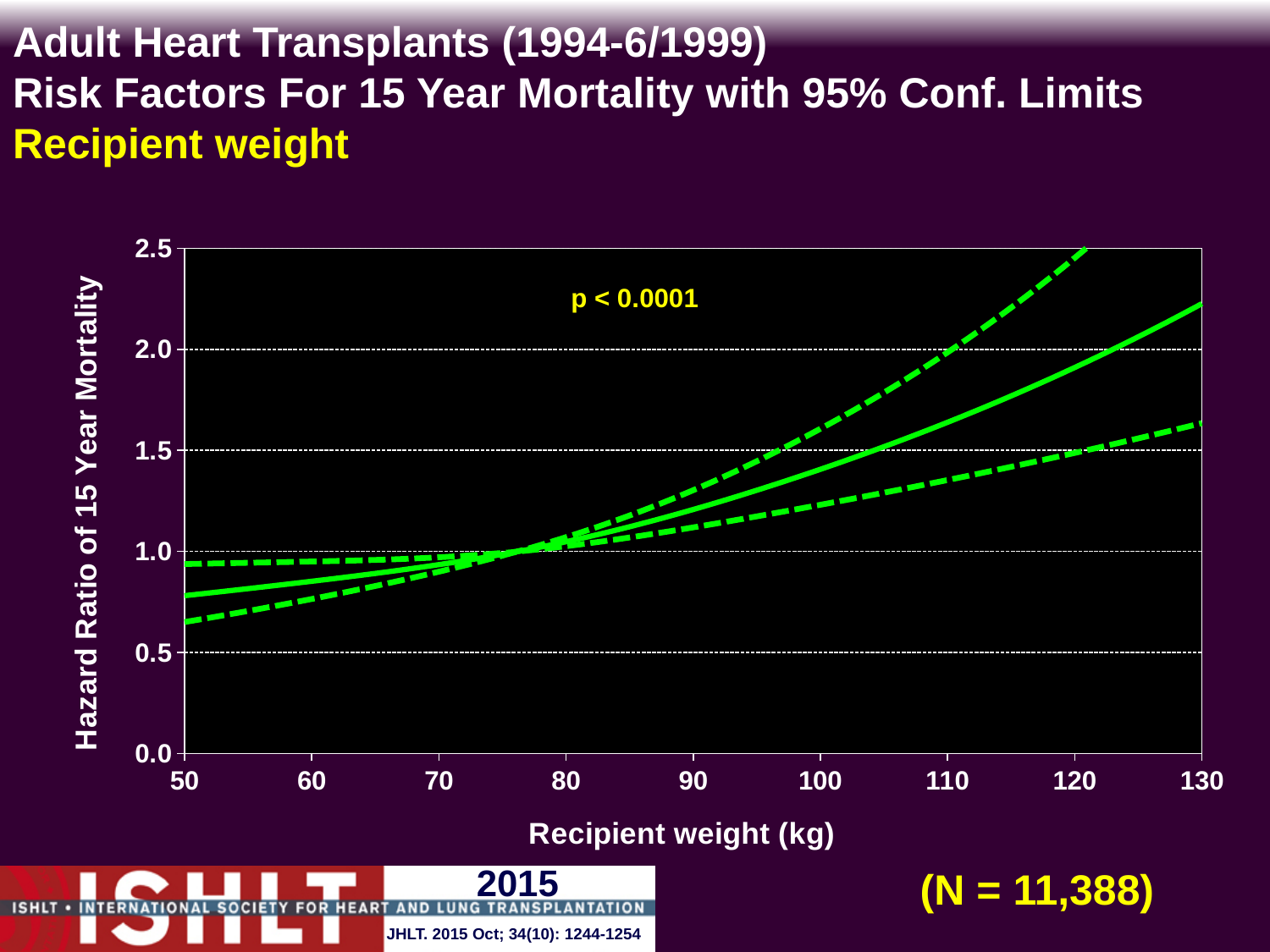
What is the lowest recipient weight shown on the x axis? 50 What kind of chart is shown on the slide? line chart Is the lower confidence limit (lower dashed line) at a recipient weight of 130 kg greater or less than 1.5? greater How many lines are plotted on the chart? 3 Is the hazard ratio (solid line) at a recipient weight of 50 kg greater or less than 1.0? less Is the hazard ratio (solid line) at a recipient weight of 130 kg greater or less than 2.0? greater What is the highest value shown on the y axis? 2.5 What is the p-value shown on the chart? p < 0.0001 What is the label of the x axis? Recipient weight (kg) Does the hazard ratio (solid line) rise or fall as recipient weight increases from 50 kg to 130 kg? rise